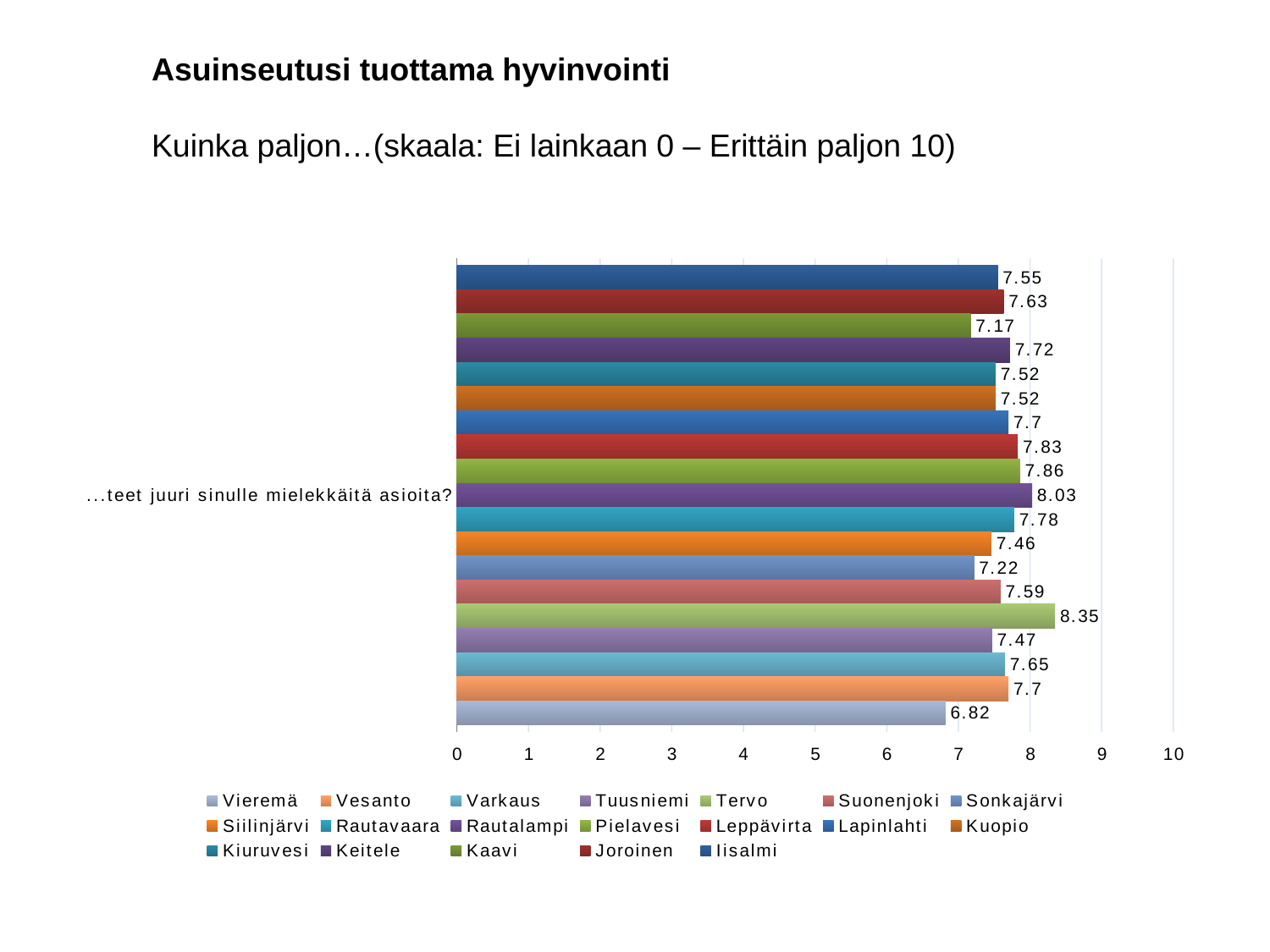
What is the highest value shown on the chart? 8.35 What kind of chart is shown on the slide? bar chart What is the value for Kaavi? 7.17 What is the difference between the highest value (8.35) and the lowest value (6.82)? 1.53 How many series does the legend list? 19 What is the value for Rautalampi? 8.03 Which municipality has the highest value? Tervo What is the maximum value shown on the horizontal axis? 10 What is the lowest value shown on the chart? 6.82 Which municipality has the lowest value? Vieremä Which is larger, the value for Tervo or the value for Vieremä? Tervo Is the value for Vieremä greater or less than 7? less